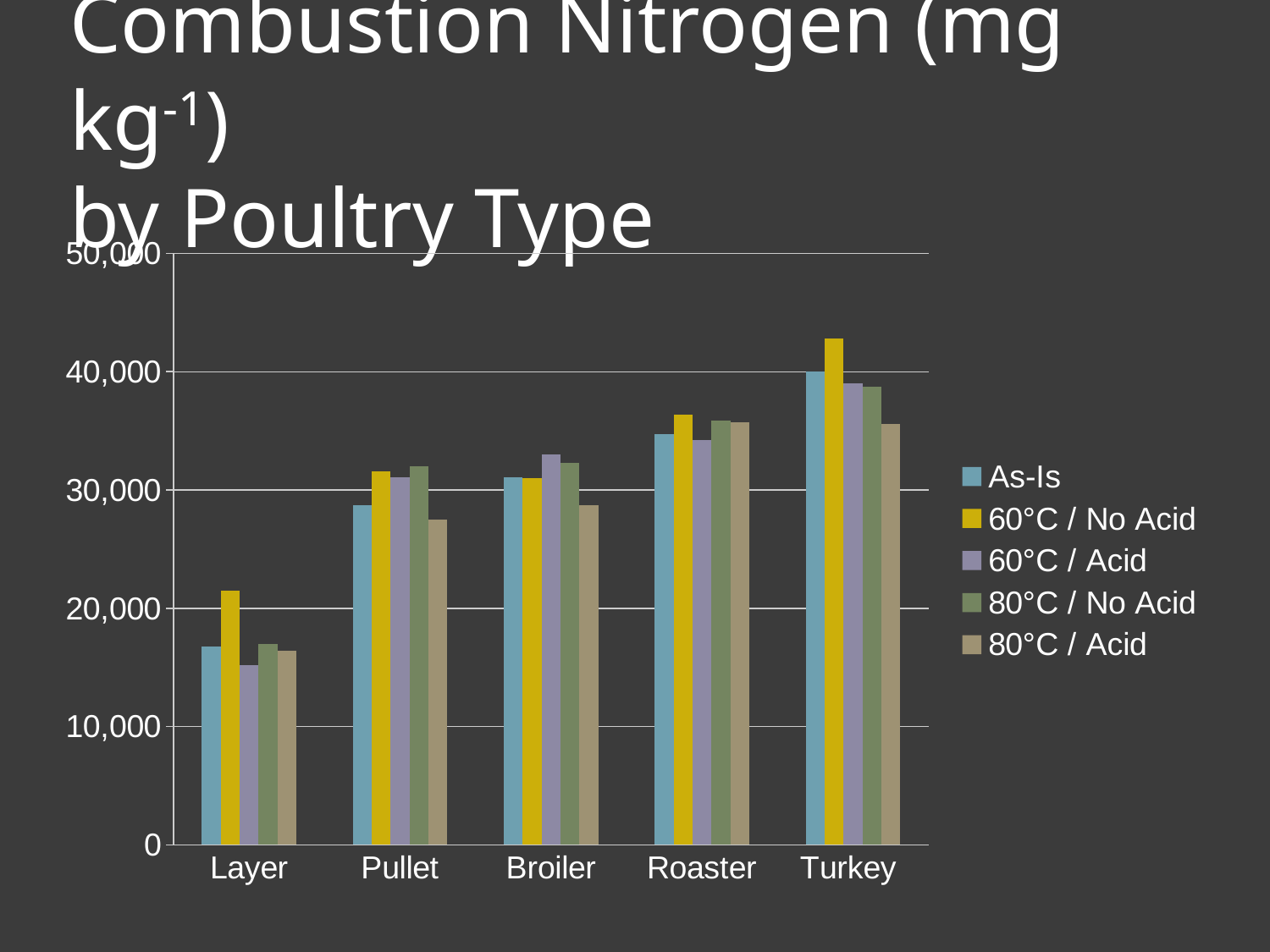
What kind of chart is shown on the slide? bar chart How many series does the legend list? 5 Do the As-Is values rise or fall from Layer to Turkey along the x axis? rise For Turkey, which is larger: the As-Is value or the 80°C / Acid value? As-Is How many poultry types are shown on the x axis? 5 Is the 80°C / Acid value for Turkey greater or less than 40,000? less Which poultry type has the lowest As-Is value? Layer Is the 60°C / No Acid value for Layer greater or less than 20,000? greater For Layer, which is larger: the 60°C / No Acid value or the 60°C / Acid value? 60°C / No Acid What is the first entry in the chart's legend? As-Is Which poultry type has the highest 60°C / No Acid value? Turkey Is the 80°C / Acid value for Pullet greater or less than 30,000? less